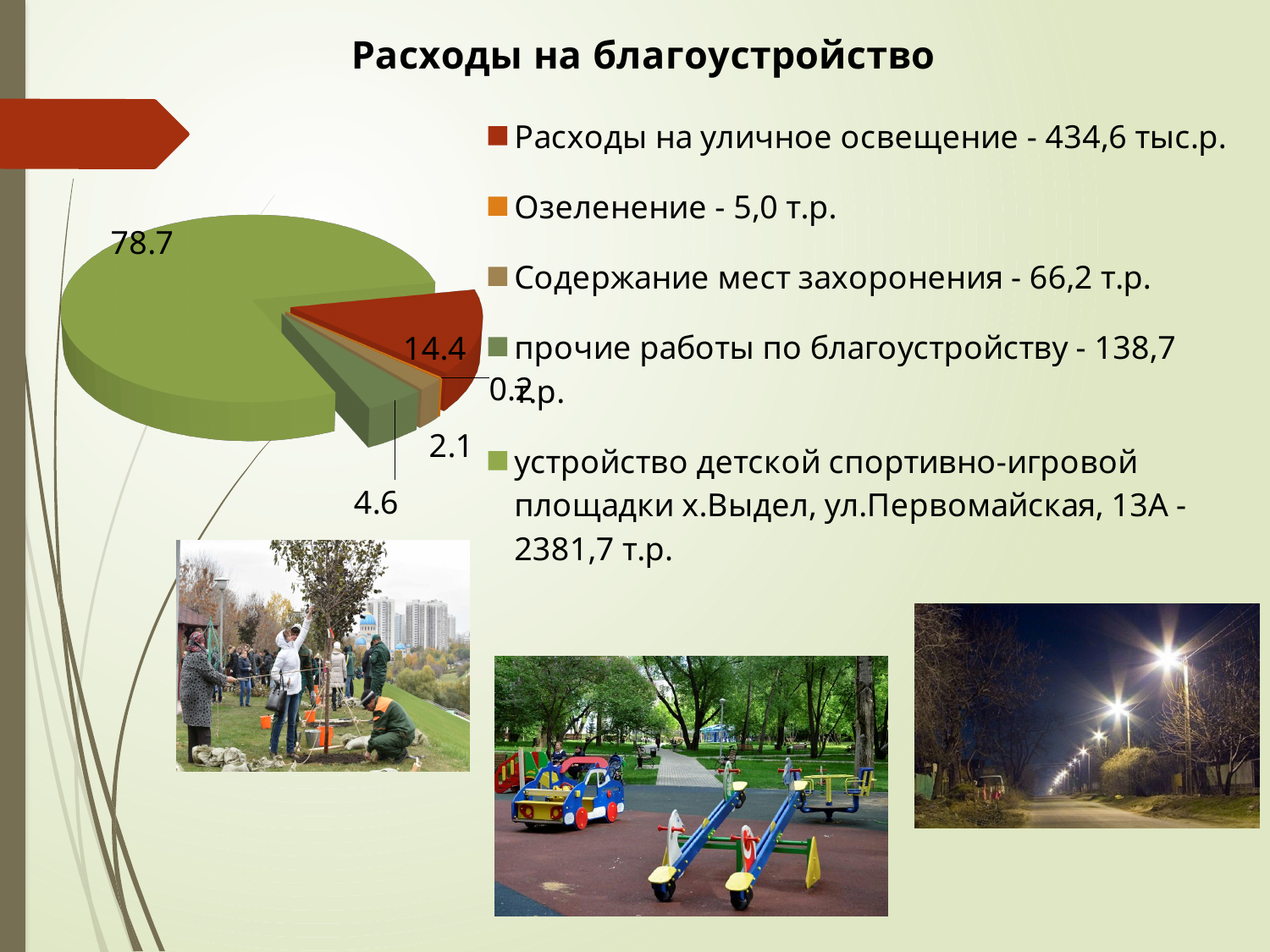
According to the legend, what amount is given for 'Расходы на уличное освещение'? 434,6 тыс.р. Which category has the largest slice of the pie? устройство детской спортивно-игровой площадки х.Выдел, ул.Первомайская, 13А What type of chart is shown on the slide? pie chart What data label is shown on the largest (light green) slice of the pie? 78.7 Which category has the smallest slice of the pie? Озеленение How many entries does the chart legend list? 5 Which slice is larger: 'Содержание мест захоронения' or 'прочие работы по благоустройству'? прочие работы по благоустройству What data label is shown on the dark green slice for 'прочие работы по благоустройству'? 4.6 What is the difference between the data labels of the largest slice (78.7) and the red slice (14.4)? 64.3 How many slices does the pie chart have? 5 What data label is shown on the red slice for 'Расходы на уличное освещение'? 14.4 What is the title of the chart on the slide? Расходы на благоустройство